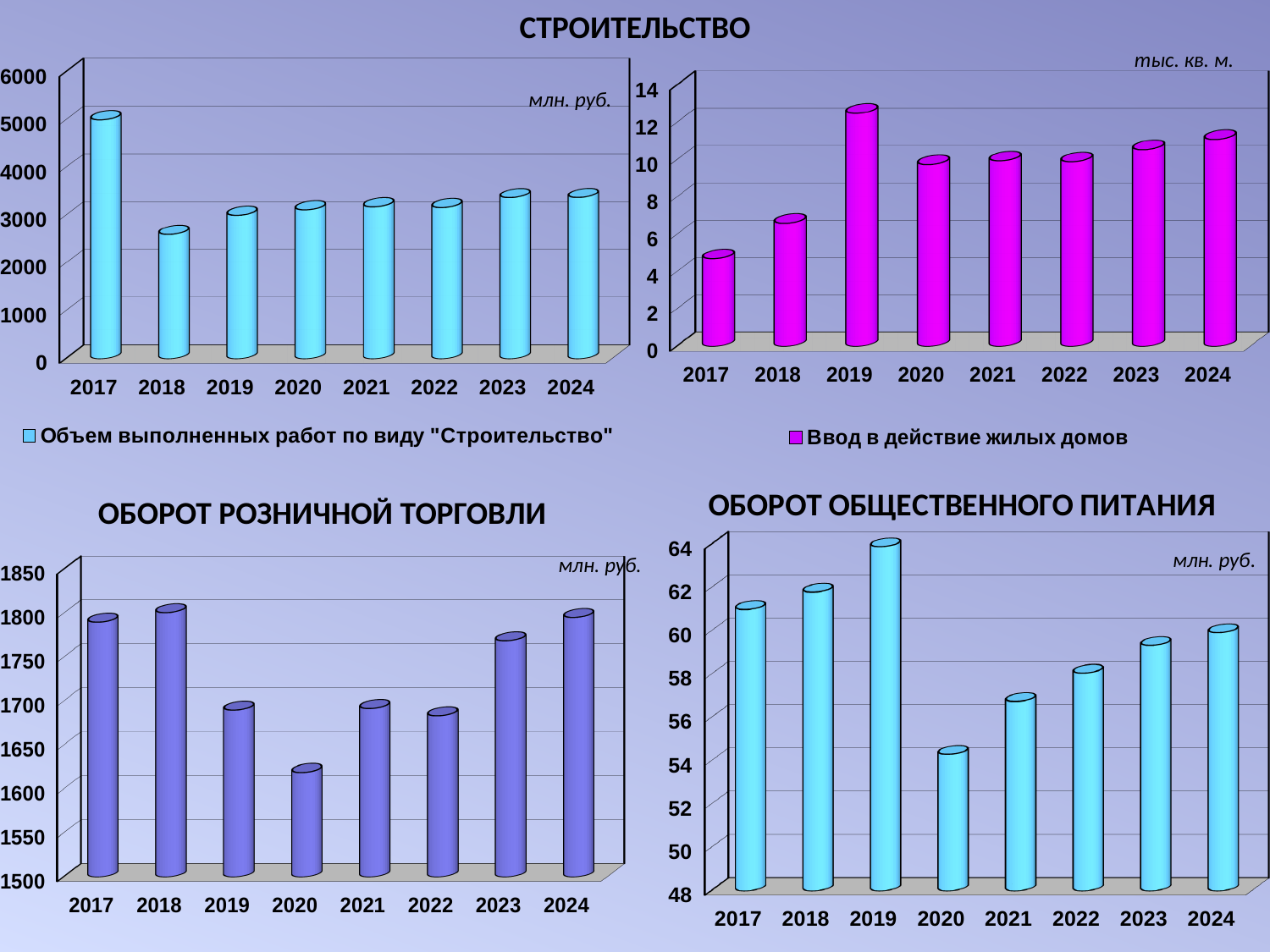
How many years are shown on the x axis of the bottom-right chart (ОБОРОТ ОБЩЕСТВЕННОГО ПИТАНИЯ)? 8 In the top-right chart (Ввод в действие жилых домов), which year has the highest value? 2019 In the bottom-right chart (ОБОРОТ ОБЩЕСТВЕННОГО ПИТАНИЯ), which year has the highest value? 2019 In the top-left chart (Объем выполненных работ по виду "Строительство"), which year has the highest value? 2017 What unit is shown on the top-right chart (Ввод в действие жилых домов)? тыс. кв. м. In the bottom-left chart (ОБОРОТ РОЗНИЧНОЙ ТОРГОВЛИ), which is larger, the value for 2018 or the value for 2019? 2018 In the bottom-left chart (ОБОРОТ РОЗНИЧНОЙ ТОРГОВЛИ), which year has the lowest value? 2020 In the top-right chart (Ввод в действие жилых домов), is the value for 2018 greater or less than 8? less In the bottom-right chart (ОБОРОТ ОБЩЕСТВЕННОГО ПИТАНИЯ), is the value for 2020 greater or less than 56? less In the top-right chart (Ввод в действие жилых домов), which year has the lowest value? 2017 In the top-left chart (Объем выполненных работ по виду "Строительство"), is the value for 2017 greater or less than 4000? greater In the top-left chart (Объем выполненных работ по виду "Строительство"), which year has the lowest value? 2018